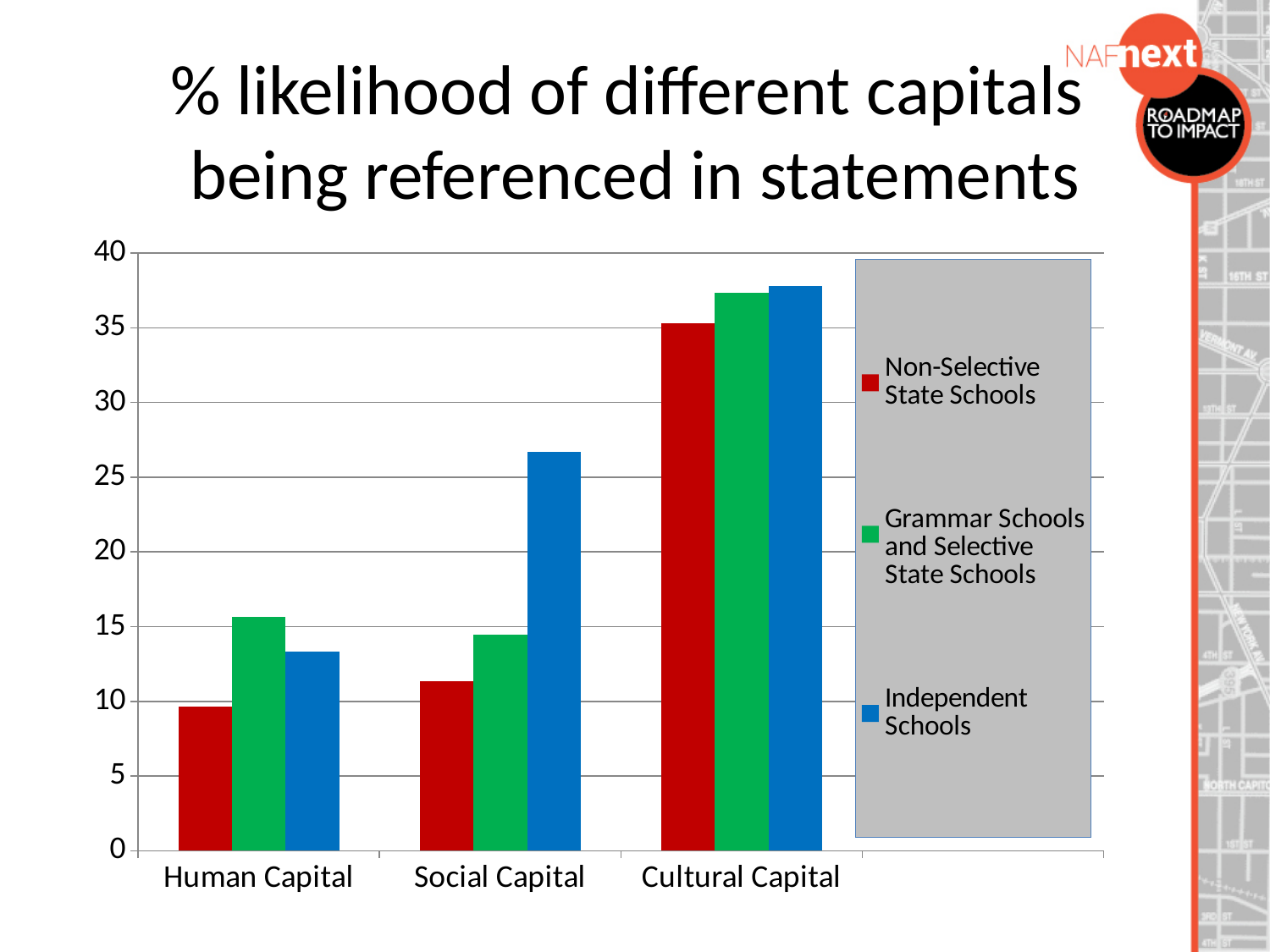
Which series has the highest value for Social Capital? Independent Schools Which category has the lowest value for Non-Selective State Schools? Human Capital Do the values for Non-Selective State Schools rise or fall from Human Capital to Cultural Capital? rise Which category has the highest value for Independent Schools? Cultural Capital For Human Capital, which is larger: the value for Grammar Schools and Selective State Schools or the value for Independent Schools? Grammar Schools and Selective State Schools Is the value for Independent Schools in Social Capital greater or less than 25? greater How many categories are shown on the x axis? 3 What kind of chart is shown on the slide? bar chart How many series does the legend list? 3 Which series has the lowest value for Human Capital? Non-Selective State Schools